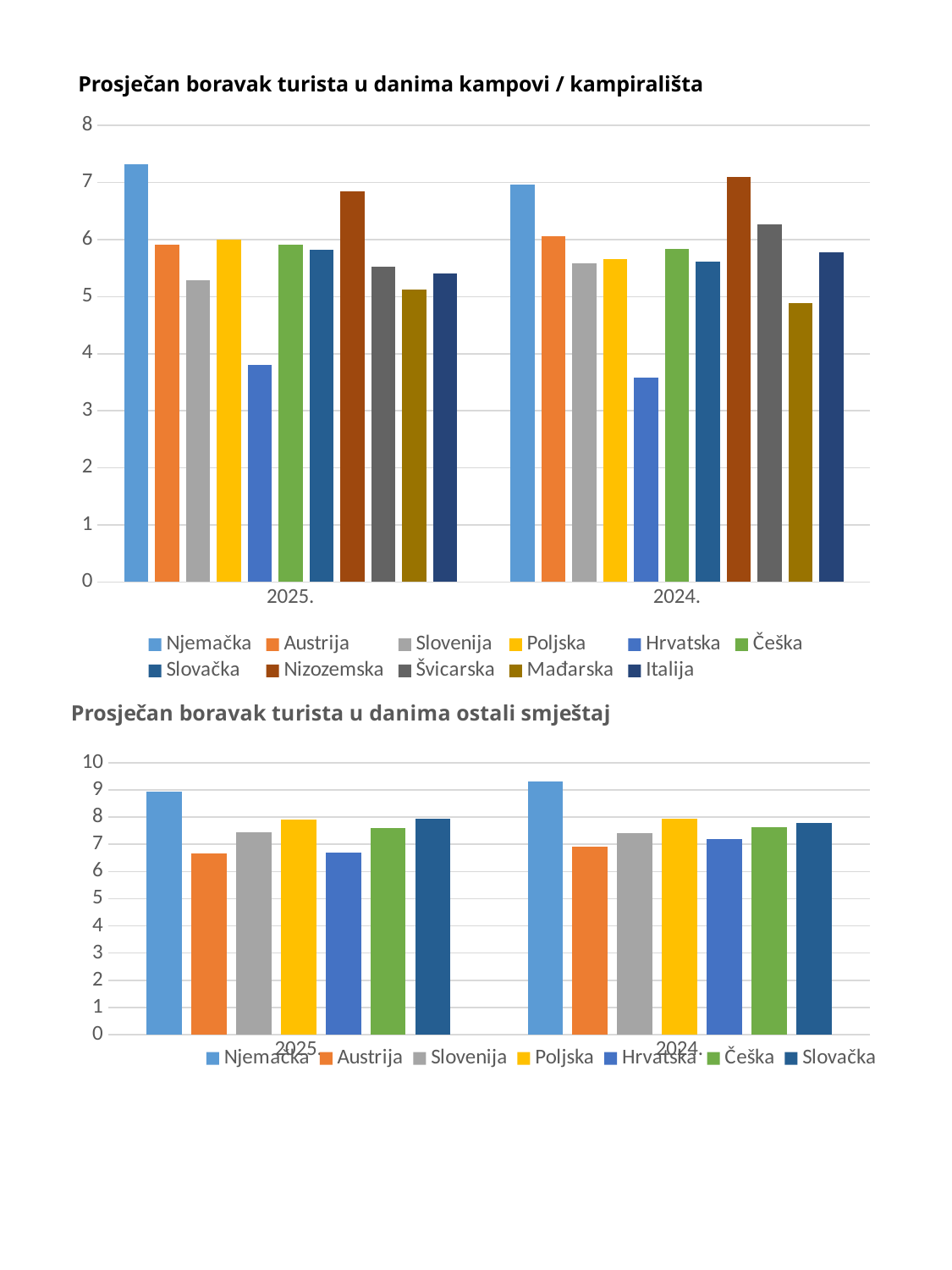
In the top chart (kampovi / kampirališta), which is larger for 2024.: Njemačka or Hrvatska? Njemačka In the bottom chart (ostali smještaj), is the value for Austrija in 2025. greater or less than 7? less In the top chart (kampovi / kampirališta), which country has the highest value for 2025.? Njemačka In the top chart (kampovi / kampirališta), how many series does the legend list? 11 In the top chart (kampovi / kampirališta), is the value for Njemačka in 2025. greater or less than 7? greater How many year categories are shown on the x axis of the bottom chart (ostali smještaj)? 2 In the bottom chart (ostali smještaj), which country has the lowest value for 2024.? Austrija In the top chart (kampovi / kampirališta), is the value for Hrvatska in 2025. greater or less than 4? less In the top chart (kampovi / kampirališta), which country has the lowest value for 2025.? Hrvatska In the bottom chart (ostali smještaj), how many series does the legend list? 7 In the bottom chart (ostali smještaj), which country has the highest value for 2024.? Njemačka What kind of chart is the top chart, 'Prosječan boravak turista u danima kampovi / kampirališta'? bar chart